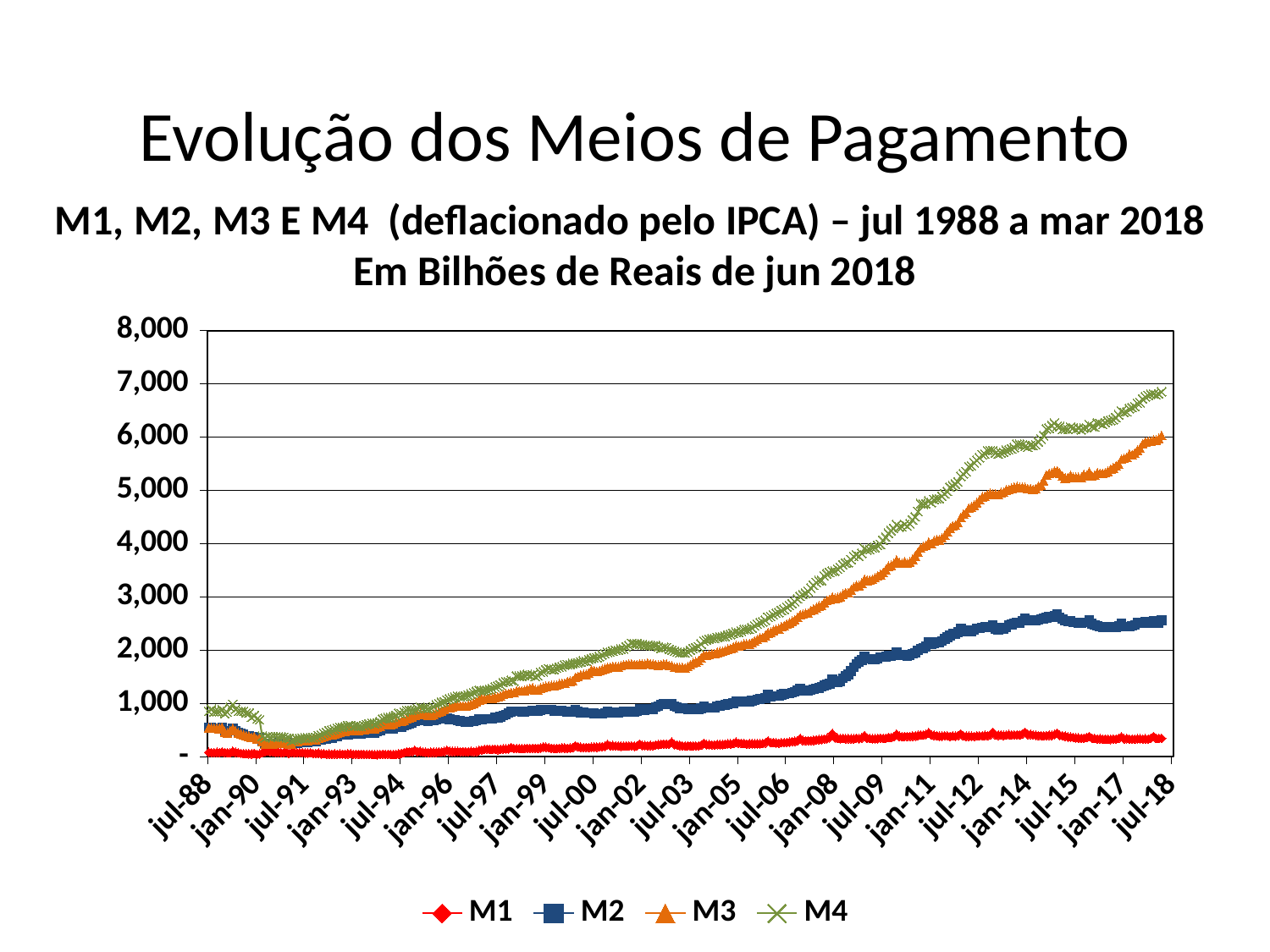
Is the value for M4 at jan-08 greater or less than 3,000? greater What kind of chart is shown on the slide? line chart Which series has the lowest value at jul-18? M1 What is the title of the slide? Evolução dos Meios de Pagamento How many series does the legend list? 4 Which series has the highest value at jul-18? M4 Is the value for M1 at jul-18 greater or less than 1,000? less Does the M4 series rise or fall overall from jul-88 to jul-18? rise What is the highest tick value shown on the y axis? 8,000 At jul-18, which is larger, M4 or M2? M4 Is the value for M2 at jul-18 greater or less than 3,000? less